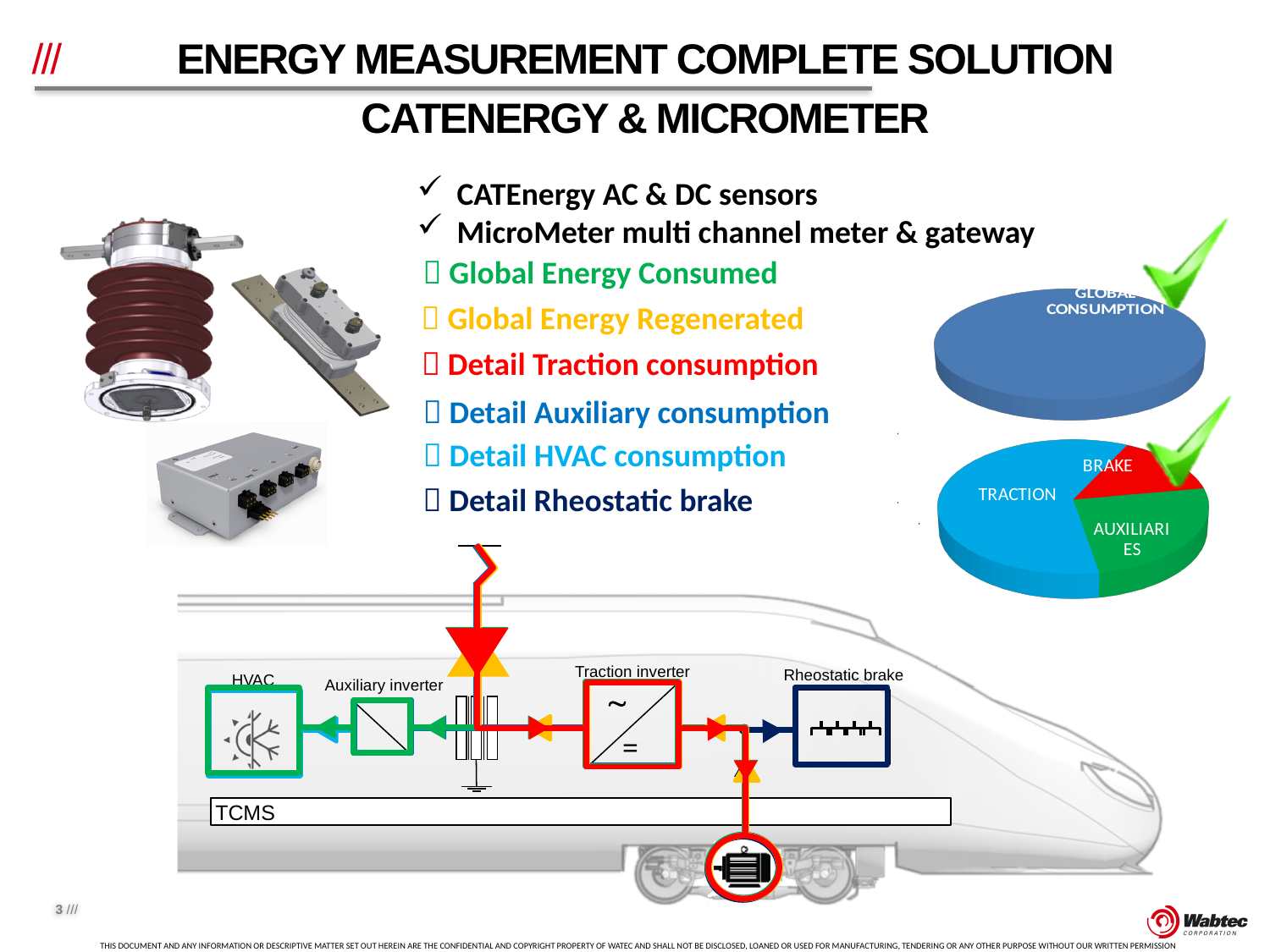
In the lower pie chart on the right, which slice is the largest? TRACTION How many slices does the upper pie chart on the right, labelled GLOBAL CONSUMPTION, show? 1 What kind of chart is the upper chart on the right side of the slide, labelled GLOBAL CONSUMPTION? Pie chart In the lower pie chart on the right, which slice is larger, TRACTION or AUXILIARIES? TRACTION In the lower pie chart on the right, which slice is the smallest? BRAKE In the lower pie chart on the right, what colour is the BRAKE slice? Red In the lower pie chart on the right, which slice is larger, AUXILIARIES or BRAKE? AUXILIARIES In the lower pie chart on the right, what colour is the TRACTION slice? Light blue In the lower pie chart on the right, how many slices are labelled? 3 What kind of chart is the lower chart on the right side of the slide, with the TRACTION, BRAKE and AUXILIARIES slices? Pie chart